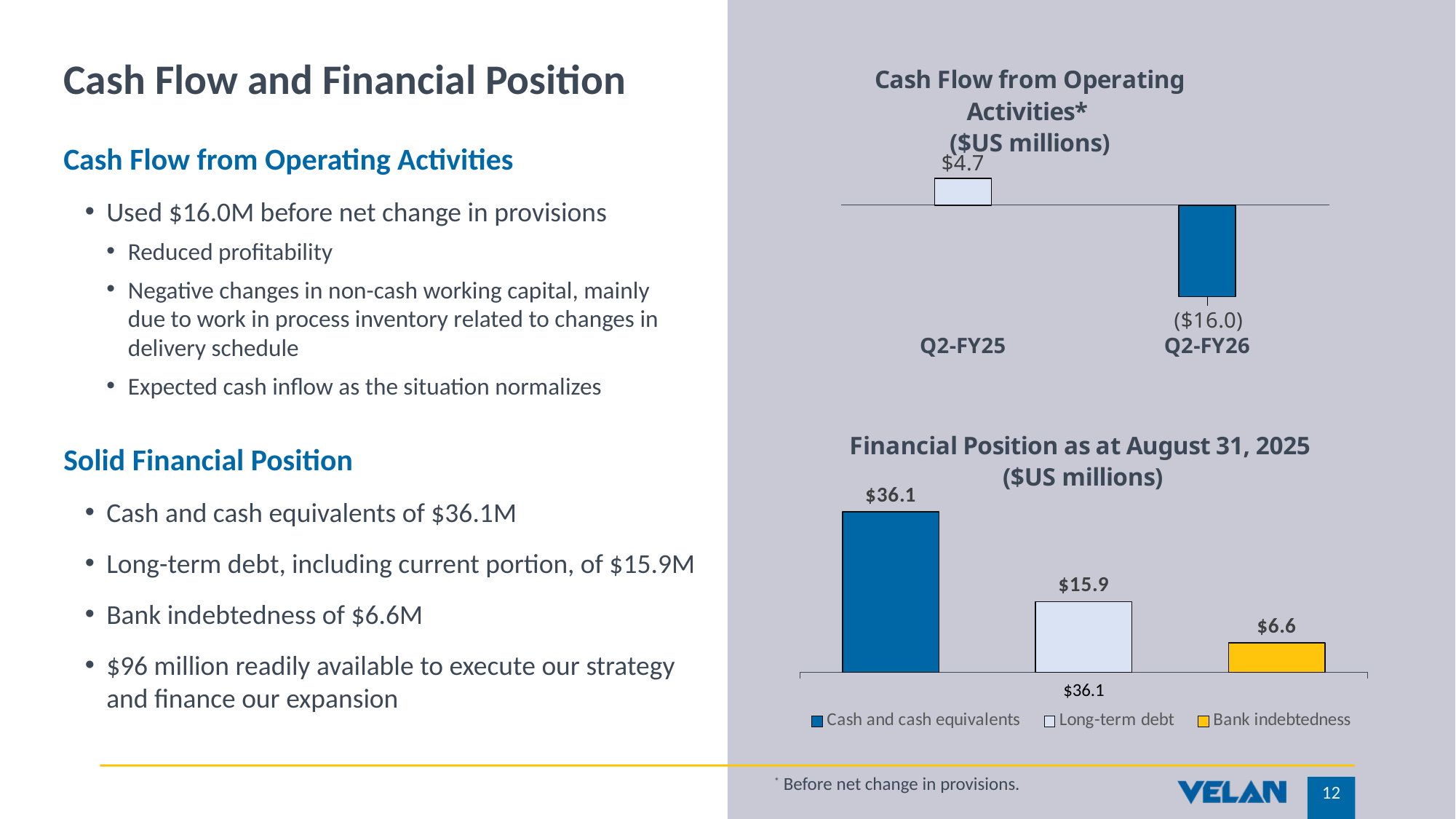
What kind of chart is the 'Cash Flow from Operating Activities' chart? bar chart In the 'Financial Position as at August 31, 2025' chart, what is the value for Long-term debt? $15.9 In the 'Financial Position as at August 31, 2025' chart, what is the value for Cash and cash equivalents? $36.1 In the 'Financial Position as at August 31, 2025' chart, which item has the lowest value? Bank indebtedness How many series does the legend of the 'Financial Position as at August 31, 2025' chart list? 3 In the 'Cash Flow from Operating Activities' chart, which period has the higher value? Q2-FY25 In the 'Cash Flow from Operating Activities' chart, what is the value for Q2-FY25? $4.7 In the 'Cash Flow from Operating Activities' chart, what is the value for Q2-FY26? ($16.0) In the 'Cash Flow from Operating Activities' chart, how many periods are plotted? 2 In the 'Financial Position as at August 31, 2025' chart, what is the difference between Cash and cash equivalents and Long-term debt? $20.2 In the 'Financial Position as at August 31, 2025' chart, what is the value for Bank indebtedness? $6.6 In the 'Cash Flow from Operating Activities' chart, does the value rise or fall from Q2-FY25 to Q2-FY26? fall